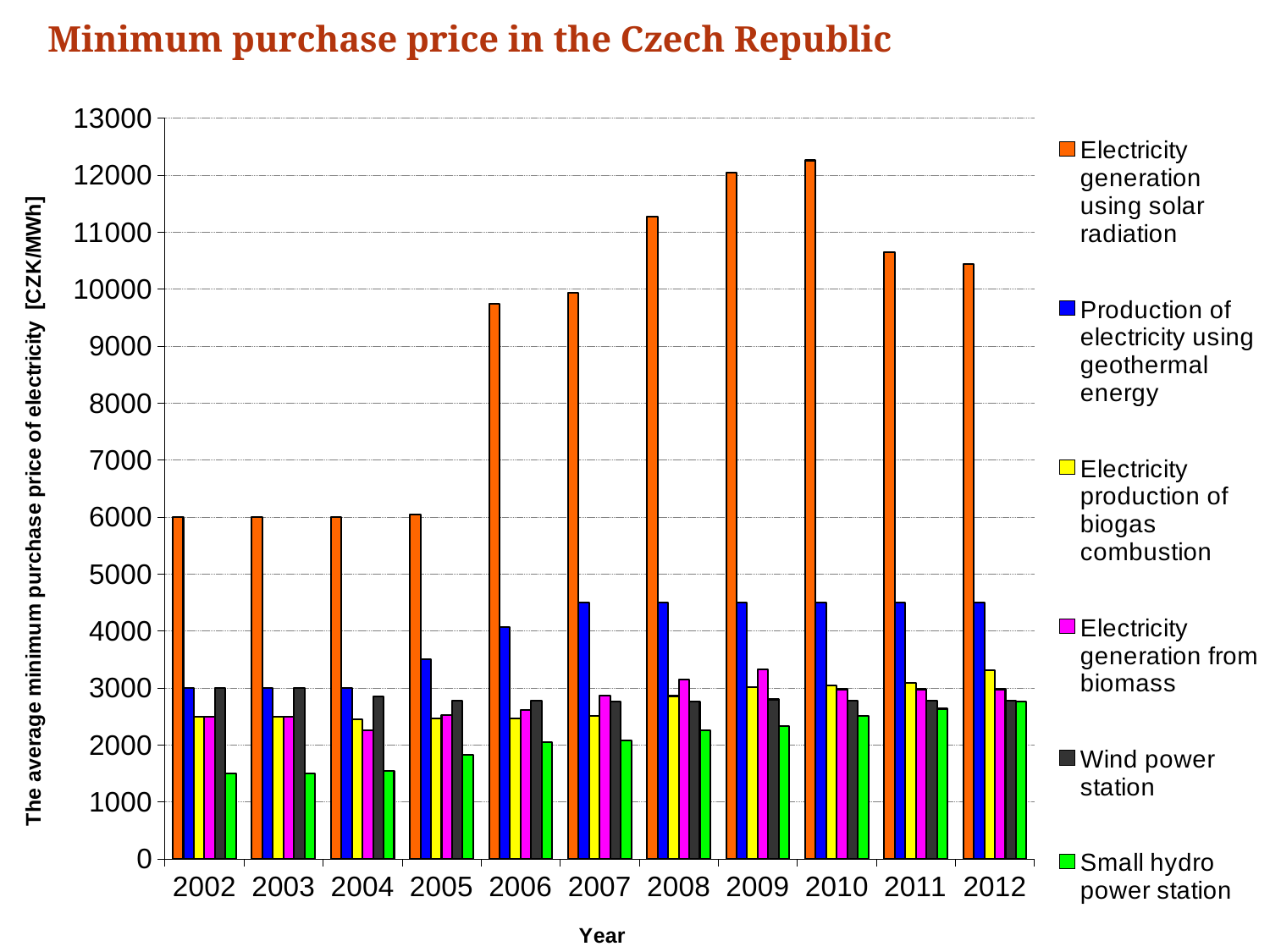
What is the title of the y axis? The average minimum purchase price of electricity [CZK/MWh] Is the value for Electricity generation using solar radiation in 2002 greater or less than 7000? less In which year is the value for Electricity generation using solar radiation the highest? 2010 Is the value for Small hydro power station in 2002 greater or less than 2000? less How many series does the legend list? 6 Is the value for Electricity generation using solar radiation in 2010 greater or less than 12000? greater How many years are shown on the x axis? 11 Which is larger for Electricity generation using solar radiation: the value in 2008 or the value in 2011? 2008 Which series has the lowest value in 2002? Small hydro power station What kind of chart is shown on the slide? bar chart Does the value for Small hydro power station rise or fall from 2002 to 2012? rise